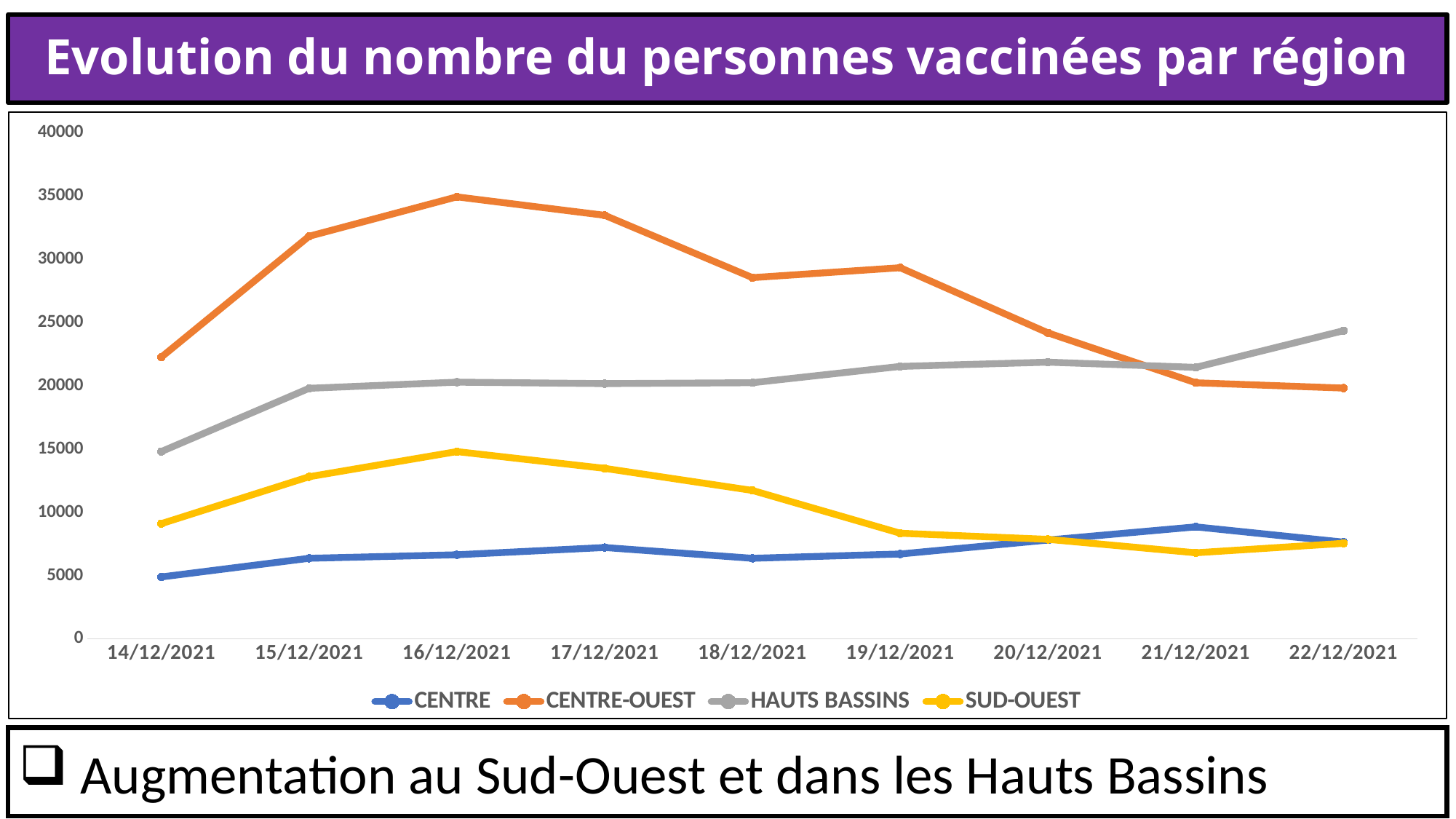
What kind of chart is shown on the slide? line chart Which region has the highest value on 16/12/2021? CENTRE-OUEST Does the CENTRE-OUEST line rise or fall between 16/12/2021 and 21/12/2021? fall Is the value for CENTRE-OUEST on 16/12/2021 greater or less than 30000? greater Which region has the lowest value on 14/12/2021? CENTRE How many dates are shown on the x axis? 9 Is the value for HAUTS BASSINS on 22/12/2021 greater or less than 20000? greater Is the value for SUD-OUEST on 21/12/2021 greater or less than 10000? less What is the title of the chart? Evolution du nombre du personnes vaccinées par région On which date does the CENTRE-OUEST line reach its highest point? 16/12/2021 On 22/12/2021, which is larger: HAUTS BASSINS or CENTRE-OUEST? HAUTS BASSINS How many series does the legend list? 4